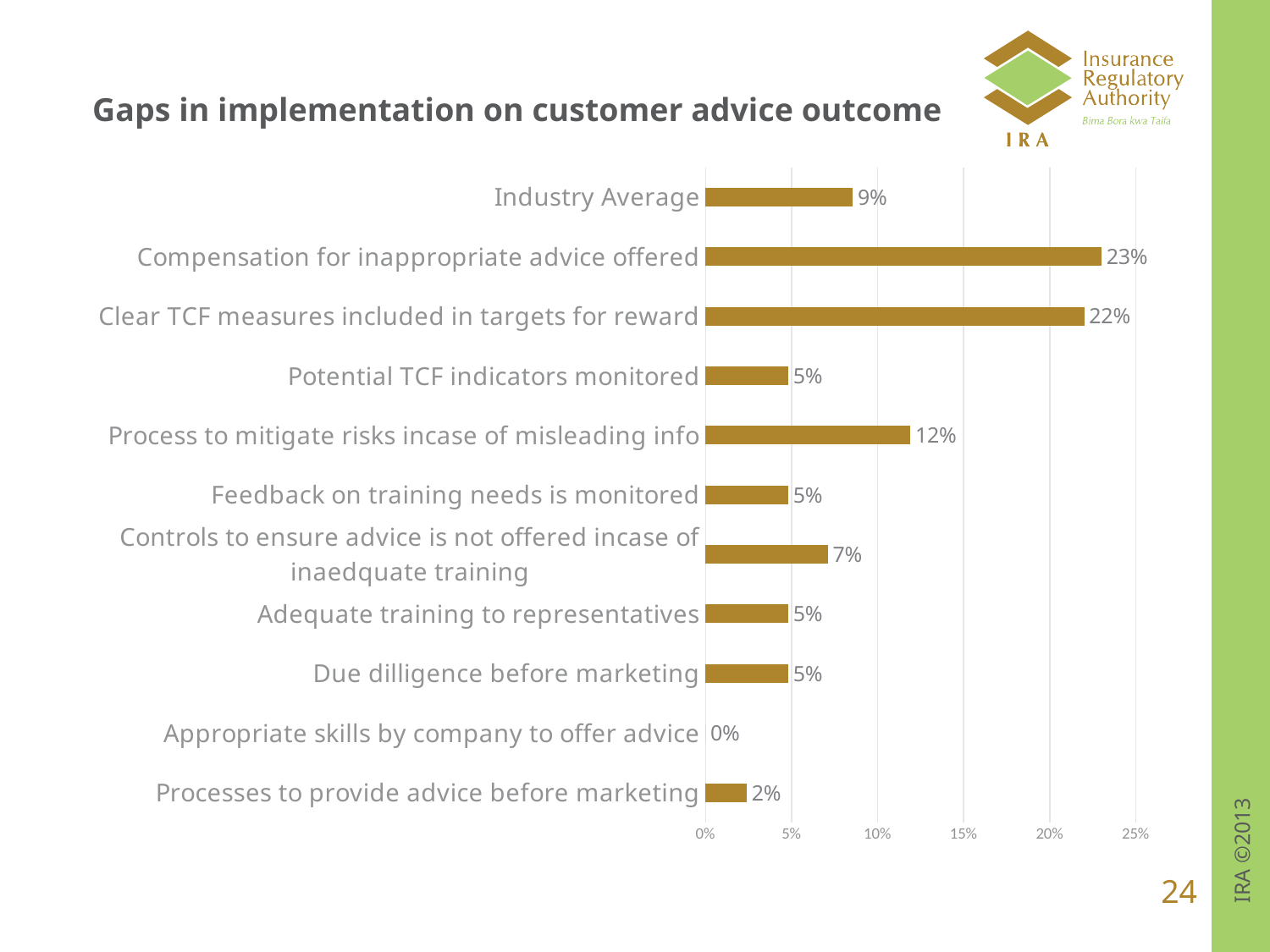
What is the value for Process to mitigate risks incase of misleading info? 12% Which category has the highest value? Compensation for inappropriate advice offered What is the difference between Process to mitigate risks incase of misleading info and Industry Average? 3% What kind of chart is shown on the slide? Bar chart Which category has the lowest value? Appropriate skills by company to offer advice Which is larger: Controls to ensure advice is not offered incase of inaedquate training or Due dilligence before marketing? Controls to ensure advice is not offered incase of inaedquate training What is the value for Industry Average? 9% What is the value for Processes to provide advice before marketing? 2% What is the value for Compensation for inappropriate advice offered? 23% What is the difference between Compensation for inappropriate advice offered and Clear TCF measures included in targets for reward? 1% What is the title of the slide? Gaps in implementation on customer advice outcome How many categories are shown in the chart? 11